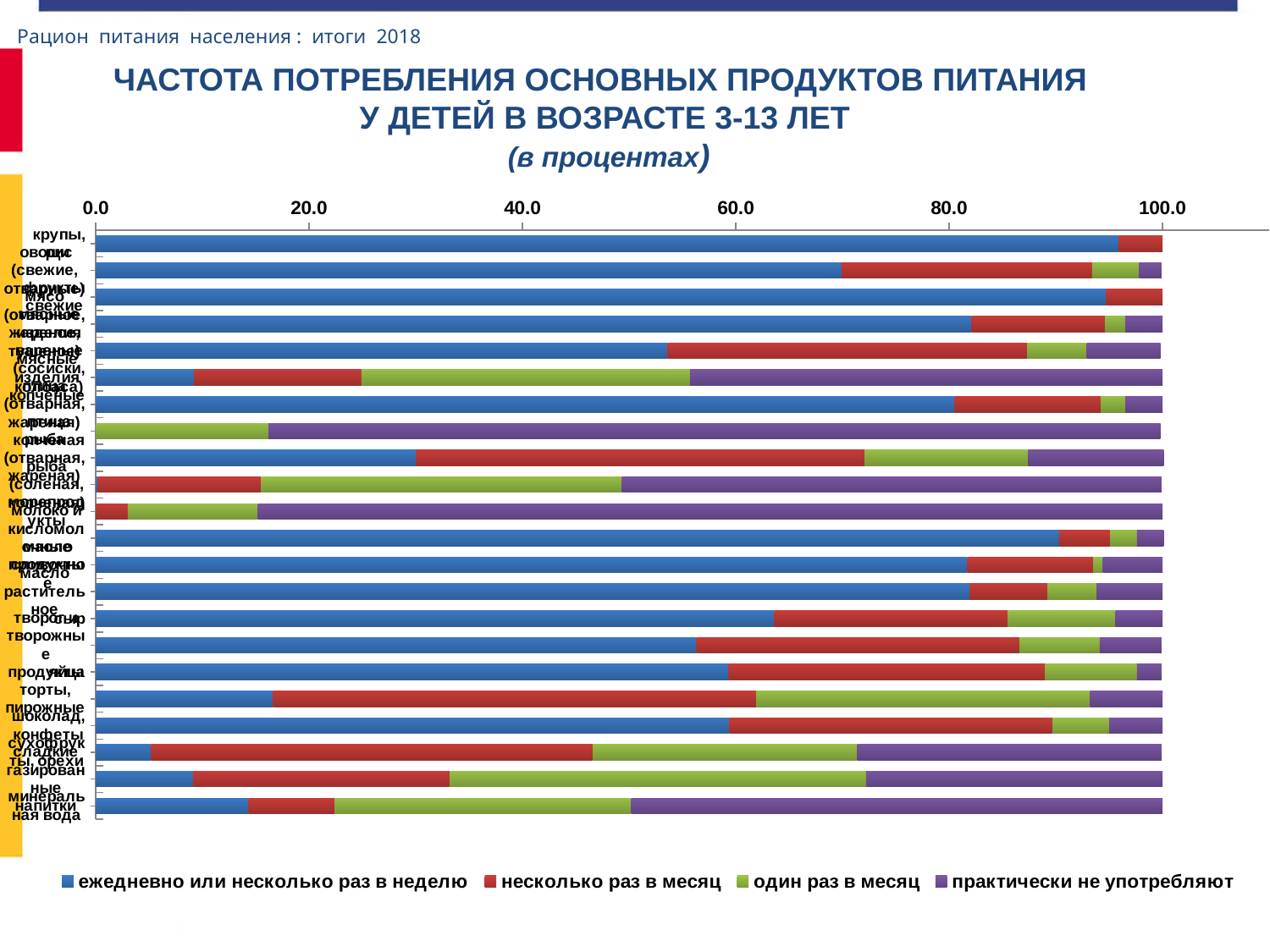
Which series is shown in green in the legend? один раз в месяц Which has the larger value of 'ежедневно или несколько раз в неделю': 'крупы, рис' or 'минеральная вода'? крупы, рис Which has the larger value of 'ежедневно или несколько раз в неделю': 'яйца' or 'газированные напитки'? яйца Is the value of 'ежедневно или несколько раз в неделю' for 'яйца' greater or less than 40.0? greater Is the value of 'ежедневно или несколько раз в неделю' for 'торты, пирожные' greater or less than 20.0? less How many series does the legend list? 4 Is the value of 'ежедневно или несколько раз в неделю' for 'минеральная вода' greater or less than 20.0? less What is the first legend entry? ежедневно или несколько раз в неделю What kind of chart is shown on the slide? stacked bar chart